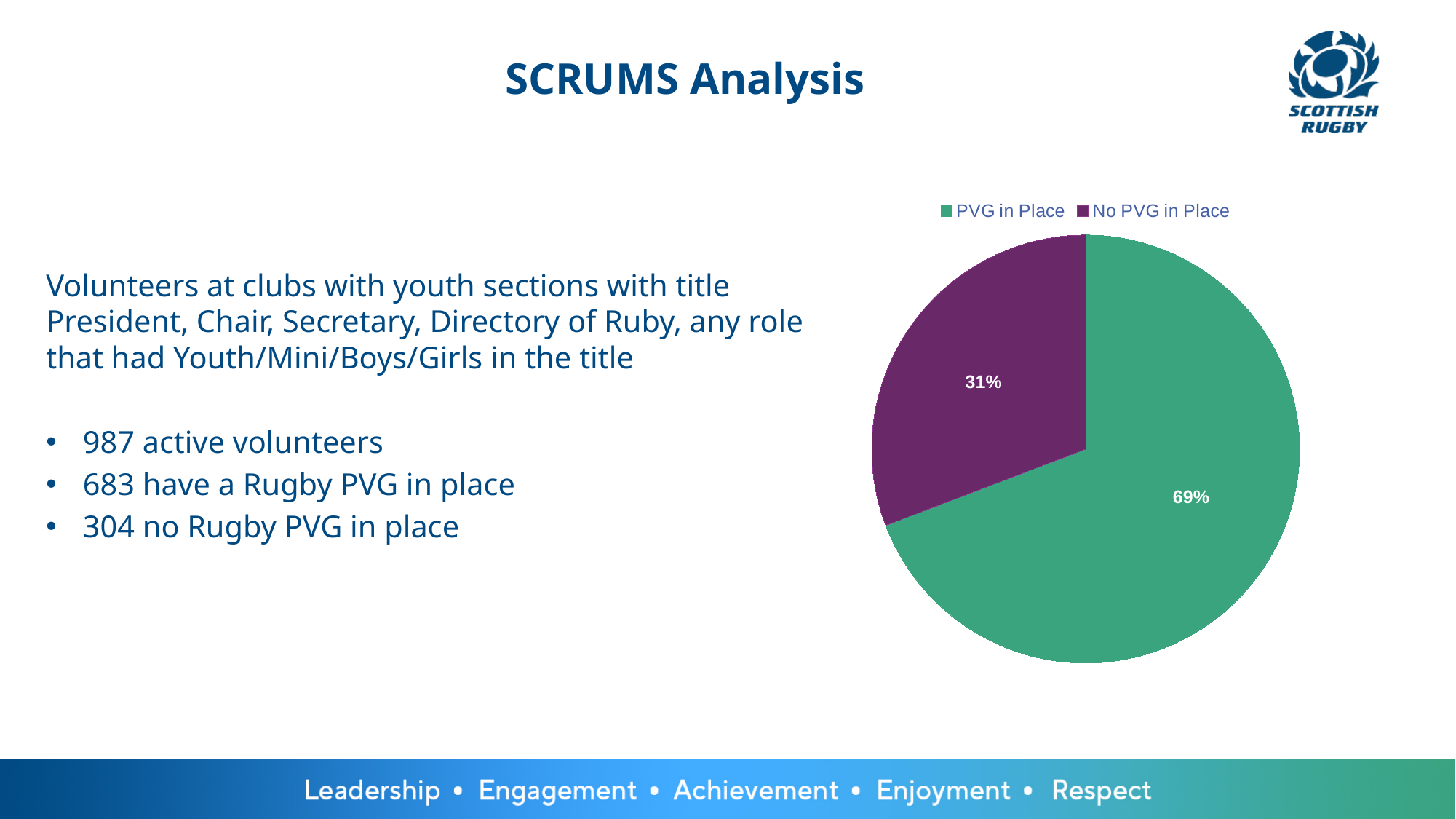
How many entries does the legend of the pie chart list? 2 What percentage of the pie is labelled for No PVG in Place? 31% Which is larger, the PVG in Place slice or the No PVG in Place slice? PVG in Place What type of chart is shown on the slide? Pie chart What colour is the No PVG in Place slice in the pie chart? Purple Which slice of the pie chart is the smallest? No PVG in Place What is the difference in percentage points between the PVG in Place slice and the No PVG in Place slice? 38 What share of the pie does the No PVG in Place slice represent? 31% Which slice of the pie chart is the largest? PVG in Place What colour is the PVG in Place slice in the pie chart? Green How many slices does the pie chart have? 2 What percentage of the pie is labelled for PVG in Place? 69%